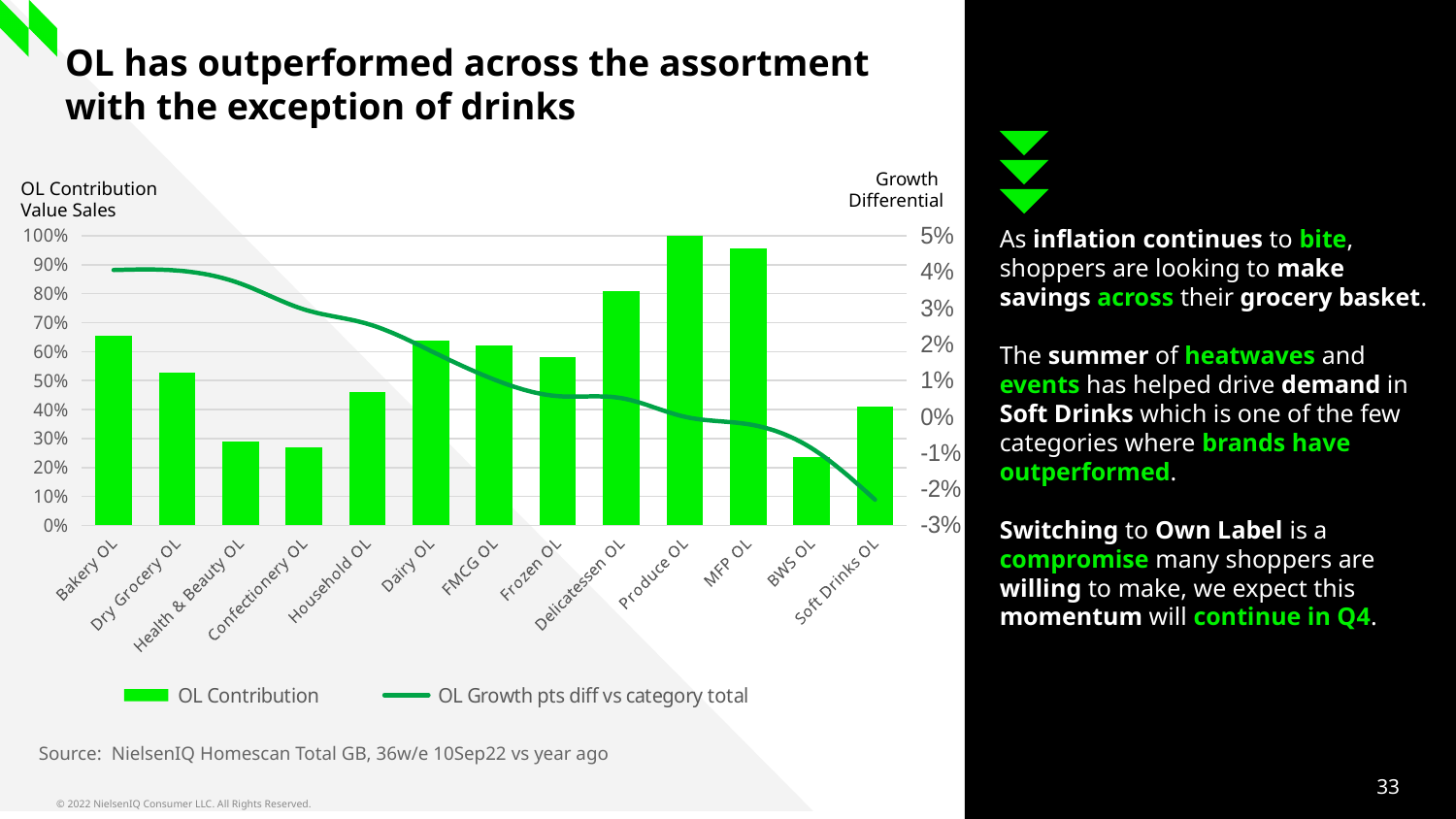
Which category has the highest OL Contribution bar? Produce OL How many categories are shown on the x axis of the chart? 13 Is the OL Contribution value for Confectionery OL greater or less than 30%? less Is the OL Contribution value for Household OL greater or less than 50%? less Which has the larger OL Contribution bar, Bakery OL or Dry Grocery OL? Bakery OL Which category has the lowest OL Contribution bar? BWS OL Is the OL Contribution value for MFP OL greater or less than 90%? greater What kind of chart is shown on the slide? A bar chart combined with a line What are the two entries in the chart legend? OL Contribution; OL Growth pts diff vs category total Does the OL Growth pts diff vs category total line rise or fall from left to right across the categories? It falls How many series does the chart legend list? 2